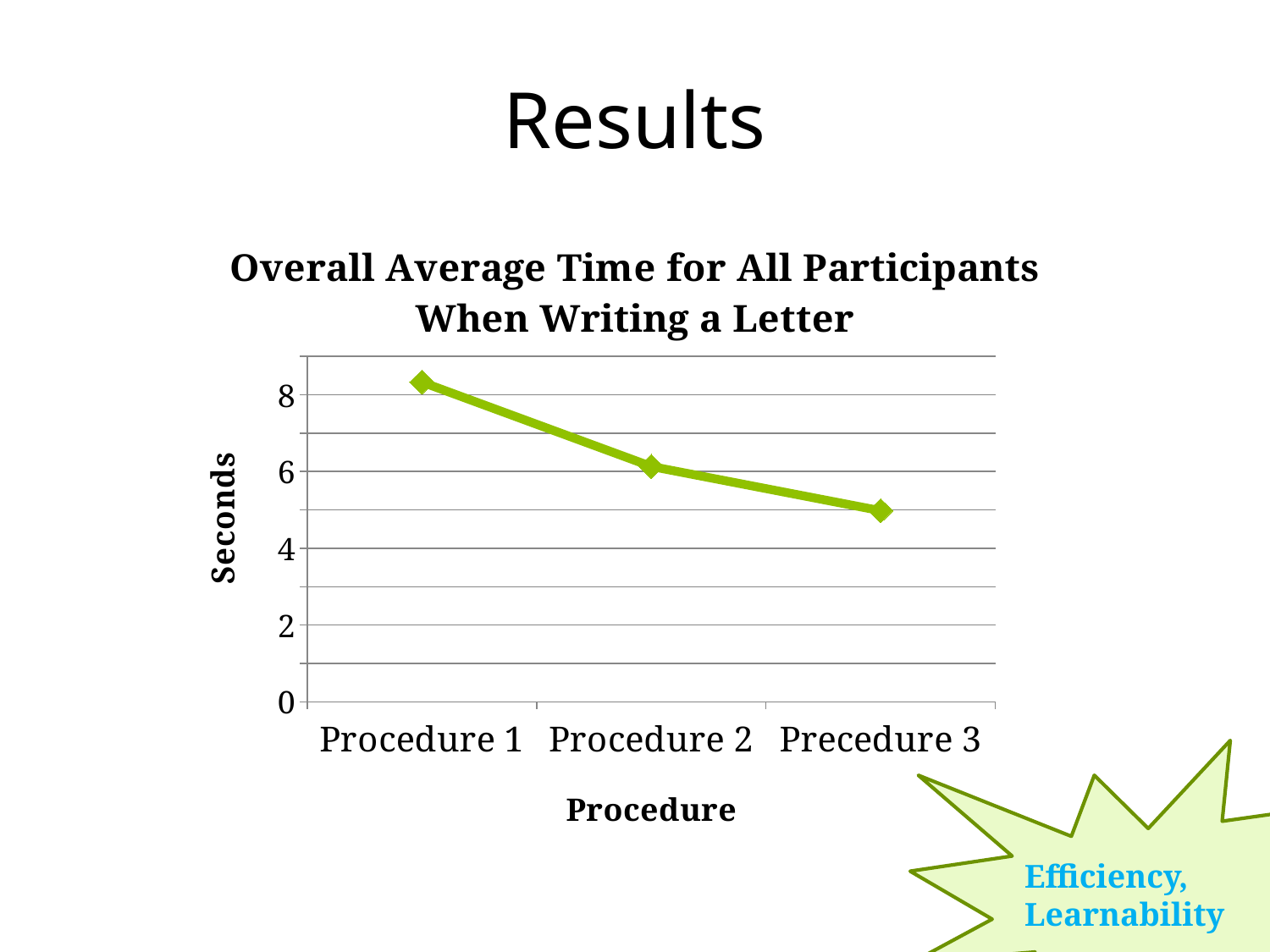
How many procedures are plotted on the x axis? 3 Do the values rise or fall from Procedure 1 to Precedure 3? fall What is the title of the chart? Overall Average Time for All Participants When Writing a Letter Which procedure has the lowest average time? Precedure 3 What kind of chart is shown on the slide? line chart Which has a larger value, Procedure 1 or Procedure 2? Procedure 1 Which has a larger value, Procedure 2 or Precedure 3? Procedure 2 What is the label on the vertical axis of the chart? Seconds Is the value for Procedure 2 greater or less than 8? less Which procedure has the highest average time? Procedure 1 Is the value for Precedure 3 greater or less than 4? greater Is the value for Procedure 1 greater or less than 6? greater